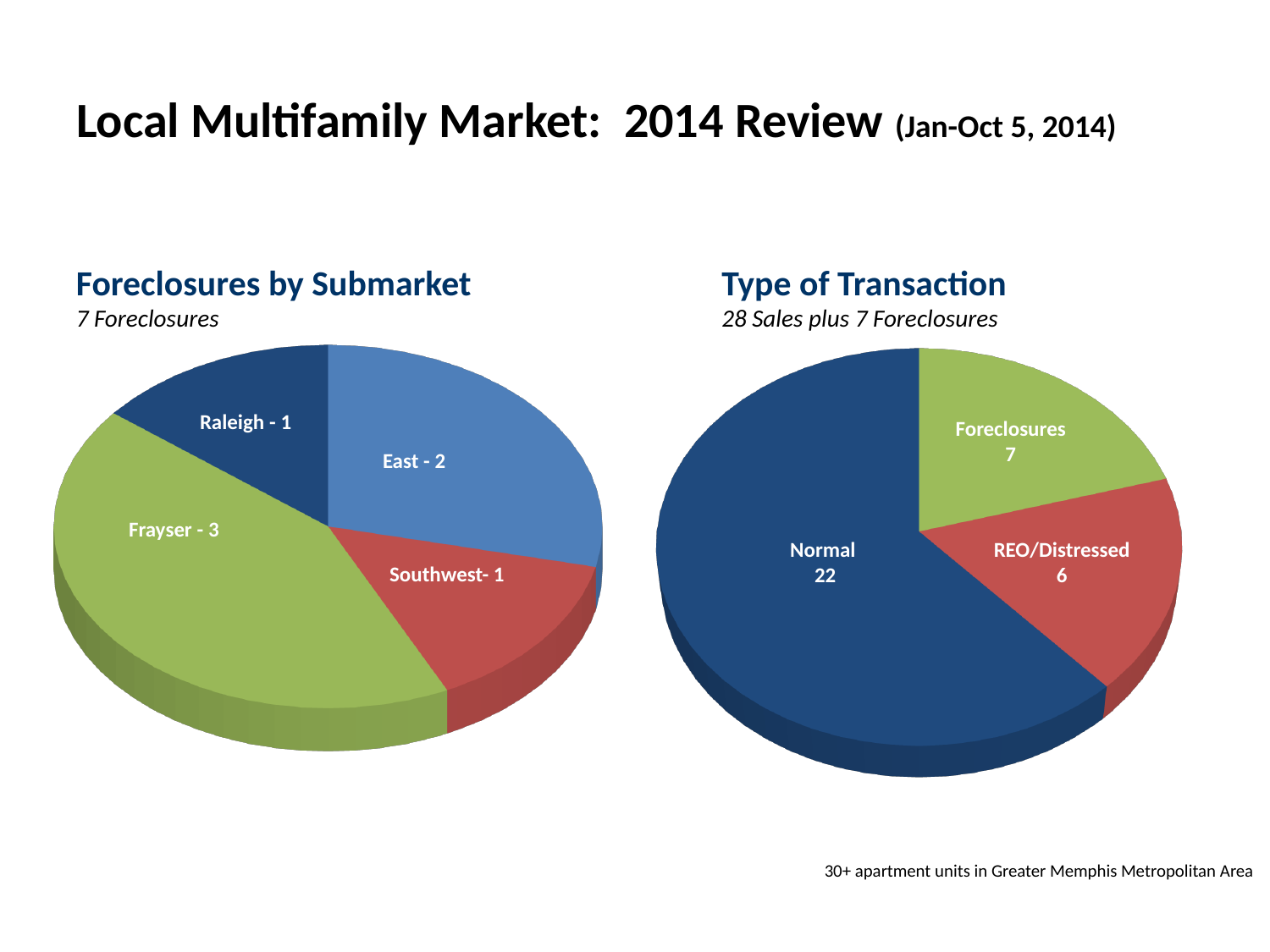
What type of chart is used for 'Type of Transaction'? Pie chart In the 'Foreclosures by Submarket' chart, how many foreclosures are in Frayser? 3 In the 'Type of Transaction' chart, how many transactions are Normal? 22 In the 'Type of Transaction' chart, what share of all transactions are Foreclosures? 20% In the 'Foreclosures by Submarket' chart, how many foreclosures are in East? 2 In the 'Type of Transaction' chart, what is the difference between Normal and Foreclosures? 15 In the 'Type of Transaction' chart, how many transactions are REO/Distressed? 6 In the 'Type of Transaction' chart, which is larger: Foreclosures or REO/Distressed? Foreclosures In the 'Foreclosures by Submarket' chart, what is the difference between the Frayser and East foreclosure counts? 1 In the 'Foreclosures by Submarket' chart, how many submarkets (slices) are shown? 4 In the 'Foreclosures by Submarket' chart, which submarket has the most foreclosures? Frayser In the 'Type of Transaction' chart, which transaction type has the smallest slice? REO/Distressed